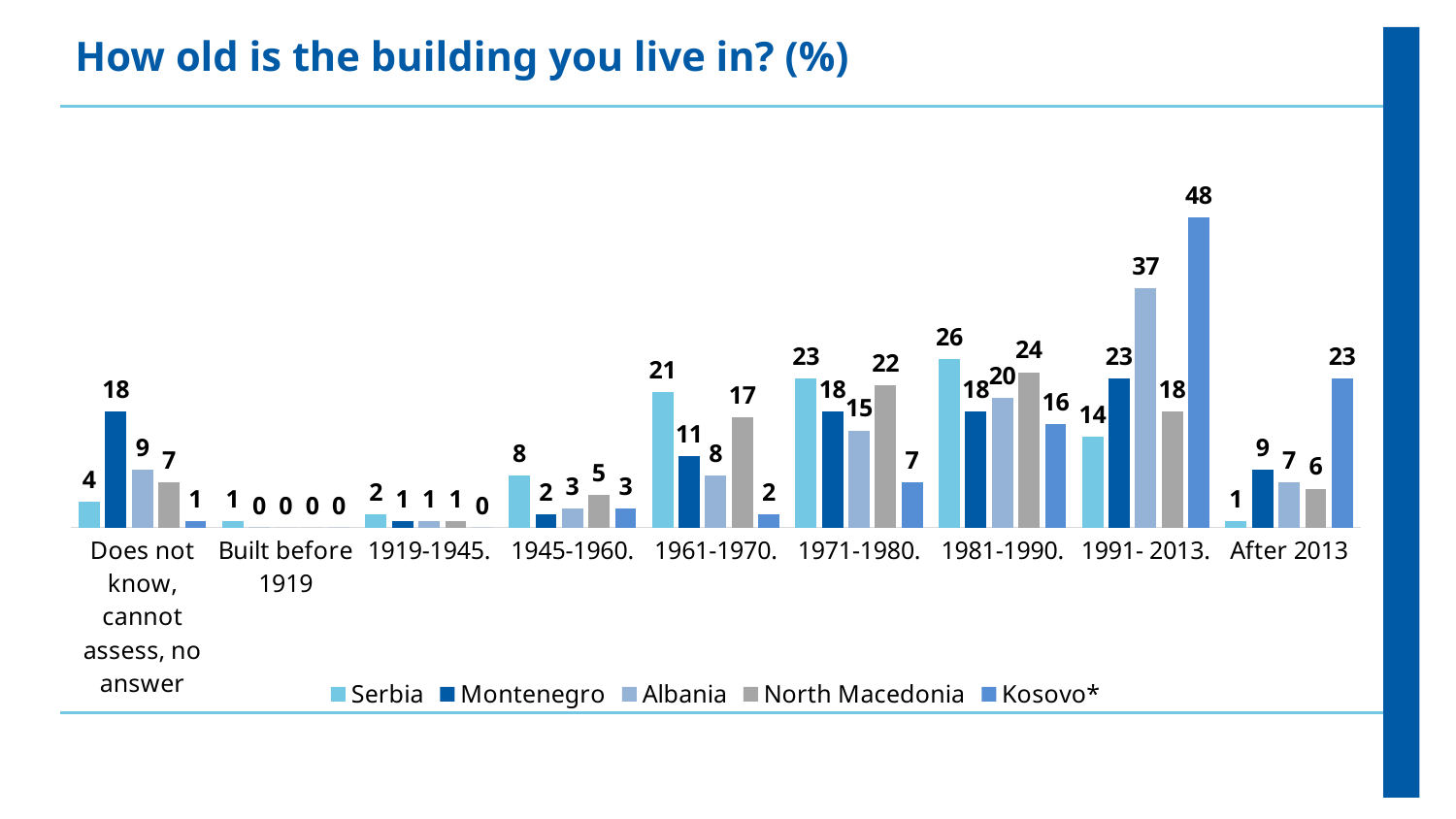
What is the title of the chart? How old is the building you live in? (%) What kind of chart is shown on the slide? Bar chart What is the difference between Albania and Serbia in the 1991- 2013. category? 23 What is the value for North Macedonia in the 1961-1970. category? 17 What is the value for Serbia in the 1981-1990. category? 26 What is the value for Montenegro in the 'Does not know, cannot assess, no answer' category? 18 Which is larger in the After 2013 category: Montenegro or Kosovo*? Kosovo* What is the value for Kosovo* in the 1991- 2013. category? 48 Which country has the highest value in the 1991- 2013. category? Kosovo* Which country has the lowest value in the 1961-1970. category? Kosovo* How many series does the legend list? 5 How many categories are shown on the x axis? 9